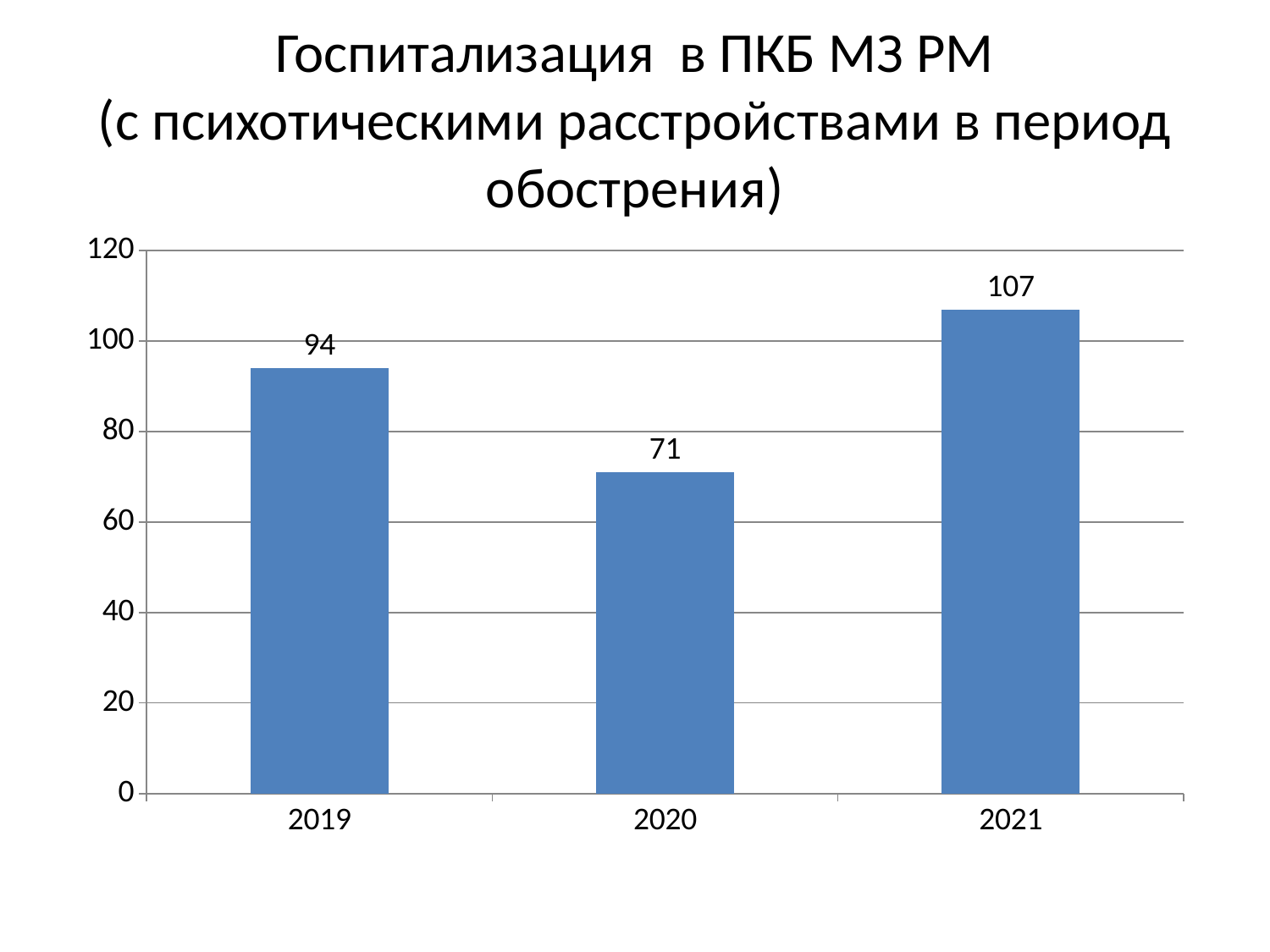
What is the difference between the values for 2021 and 2020? 36 What is the title of the chart? Госпитализация в ПКБ МЗ РМ (с психотическими расстройствами в период обострения) What is the value for 2021? 107 What is the value for 2019? 94 Which is larger, the value for 2019 or the value for 2021? 2021 Is the value for 2020 greater or less than 80? less How many years are shown on the x axis? 3 What is the value for 2020? 71 Which year has the lowest value? 2020 What kind of chart is shown on the slide? bar chart What is the difference between the values for 2019 and 2020? 23 Which year has the highest value? 2021